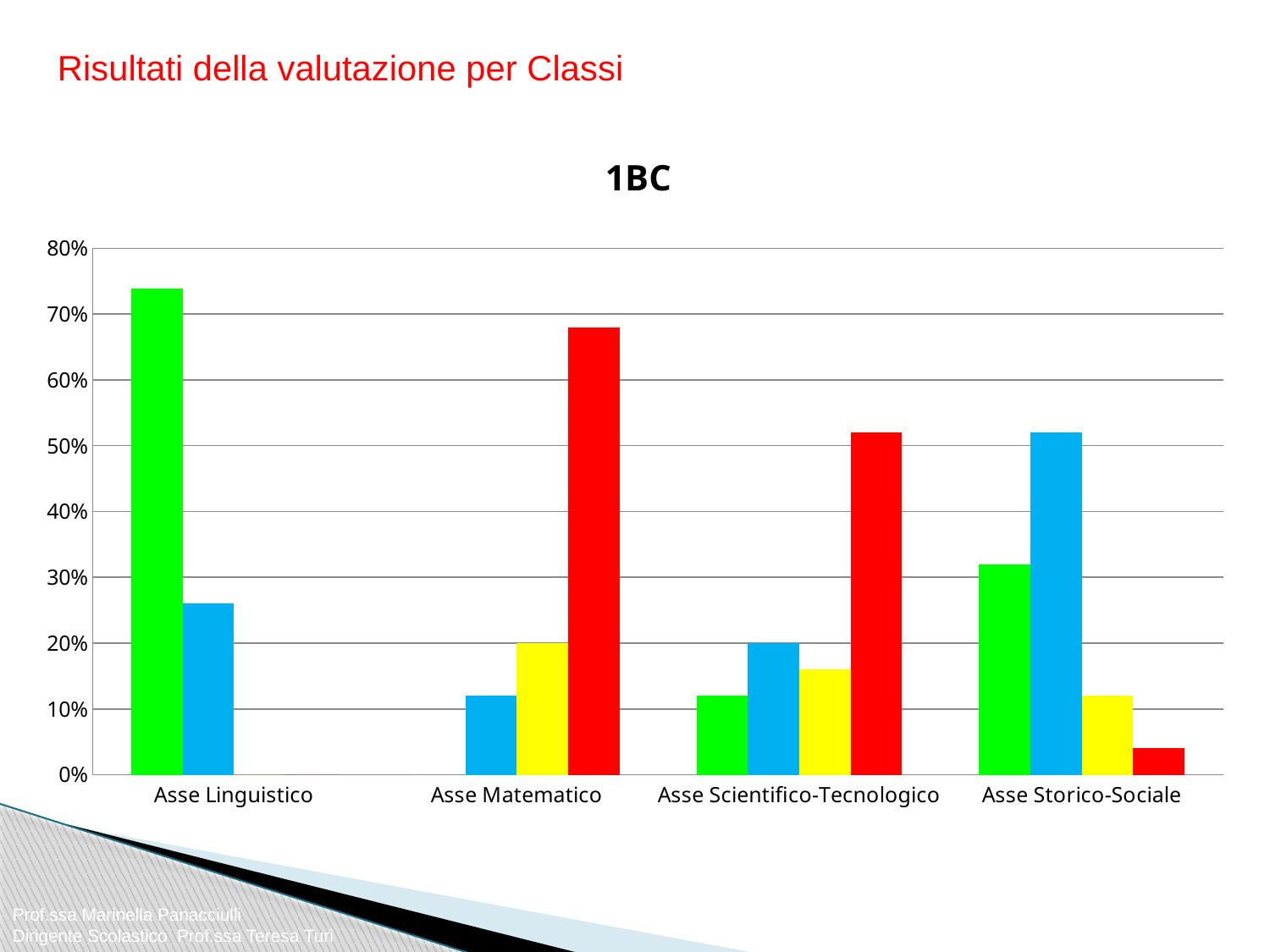
How many categories are shown on the x axis? 4 Is the value of the green bar for Asse Linguistico greater or less than 70%? greater Is the value of the green bar for Asse Storico-Sociale greater or less than 30%? greater Is the value of the red bar for Asse Matematico greater or less than 70%? less Which is larger: the green bar for Asse Linguistico or the red bar for Asse Matematico? the green bar for Asse Linguistico Which category contains the tallest bar in the chart? Asse Linguistico What is the title of the chart? 1BC Which category contains the shortest bar in the chart? Asse Storico-Sociale How many bars are plotted for Asse Linguistico? 2 What kind of chart is shown on the slide? bar chart